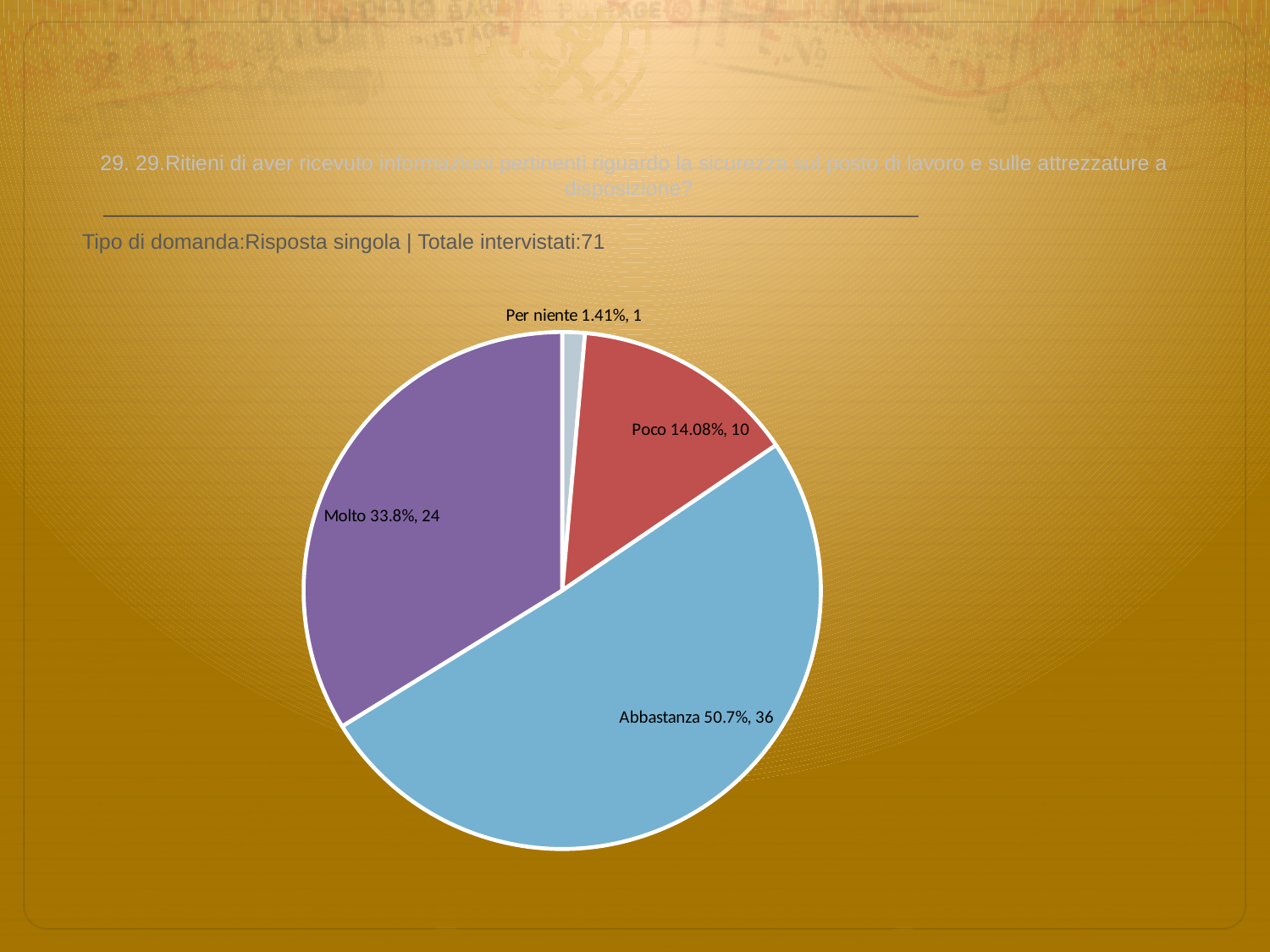
What is the difference in respondent count between 'Abbastanza' and 'Molto'? 12 Which has more respondents, 'Poco' or 'Molto'? Molto What kind of chart is shown on the slide? pie chart How many respondents answered 'Molto'? 24 What percentage share does the 'Per niente' slice have? 1.41% What is the total number of respondents shown on the slide? 71 Which category has the largest slice? Abbastanza Which category has the smallest slice? Per niente What percentage share does the 'Abbastanza' slice have? 50.7% How many slices does the pie chart have? 4 How many respondents answered 'Poco'? 10 What colour is the 'Abbastanza' slice? light blue